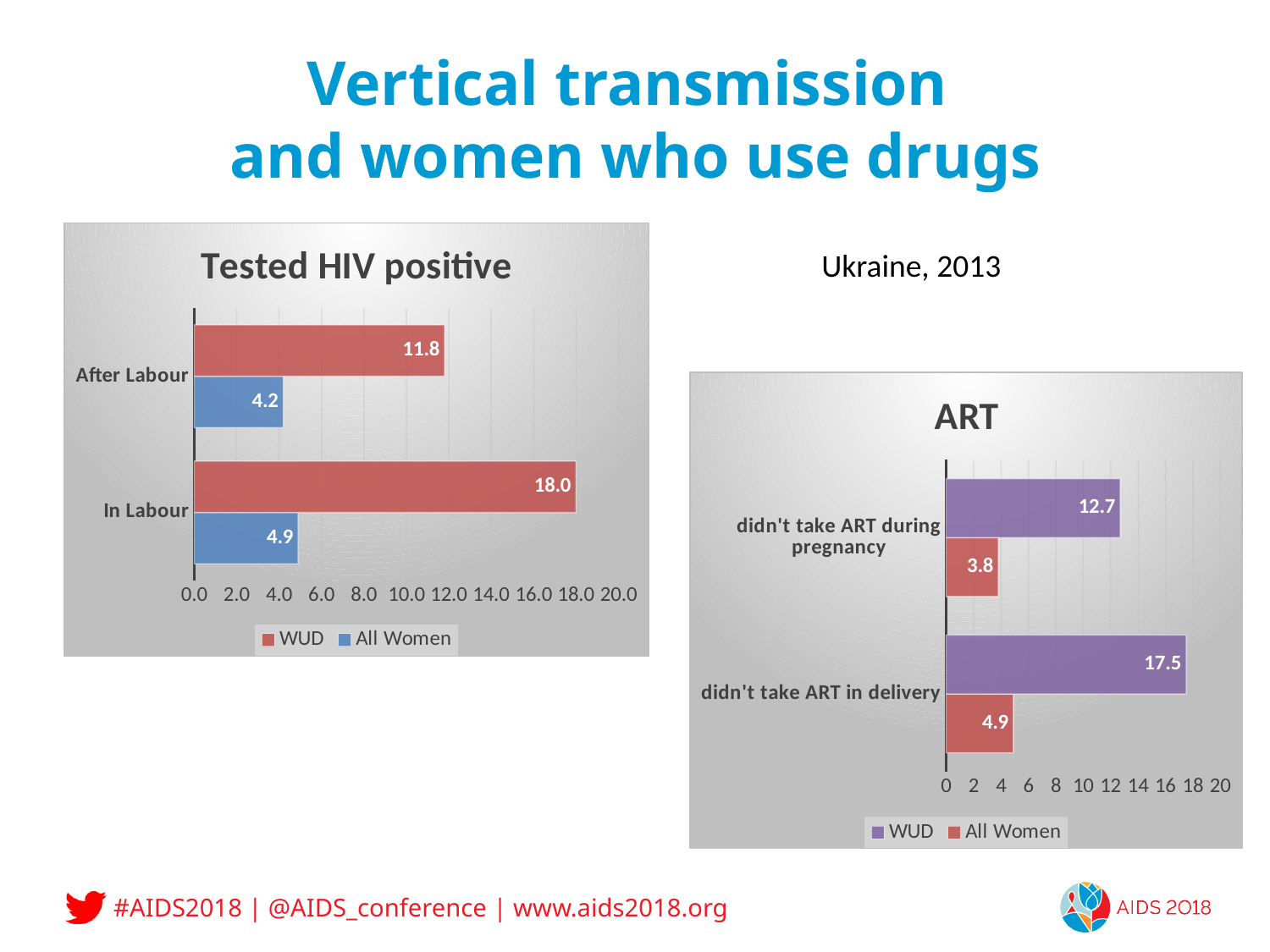
In the 'ART' chart, what is the value for All Women in the 'didn't take ART during pregnancy' category? 3.8 In the 'Tested HIV positive' chart, which category has the highest WUD value? In Labour In the 'Tested HIV positive' chart, what is the value for WUD in the 'In Labour' category? 18.0 In the 'ART' chart, what colour are the WUD bars? Purple In the 'Tested HIV positive' chart, what is the value for All Women in the 'After Labour' category? 4.2 In the 'ART' chart, which is larger: the WUD value for 'didn't take ART in delivery' or the WUD value for 'didn't take ART during pregnancy'? didn't take ART in delivery In the 'ART' chart, what is the value for WUD in the 'didn't take ART in delivery' category? 17.5 In the 'ART' chart, how many categories are shown? 2 In the 'Tested HIV positive' chart, how many series does the legend list? 2 In the 'Tested HIV positive' chart, what is the difference between the WUD and All Women values for 'In Labour'? 13.1 In the 'ART' chart, what is the difference between the WUD and All Women values for 'didn't take ART during pregnancy'? 8.9 What kind of chart is the 'ART' chart? Bar chart